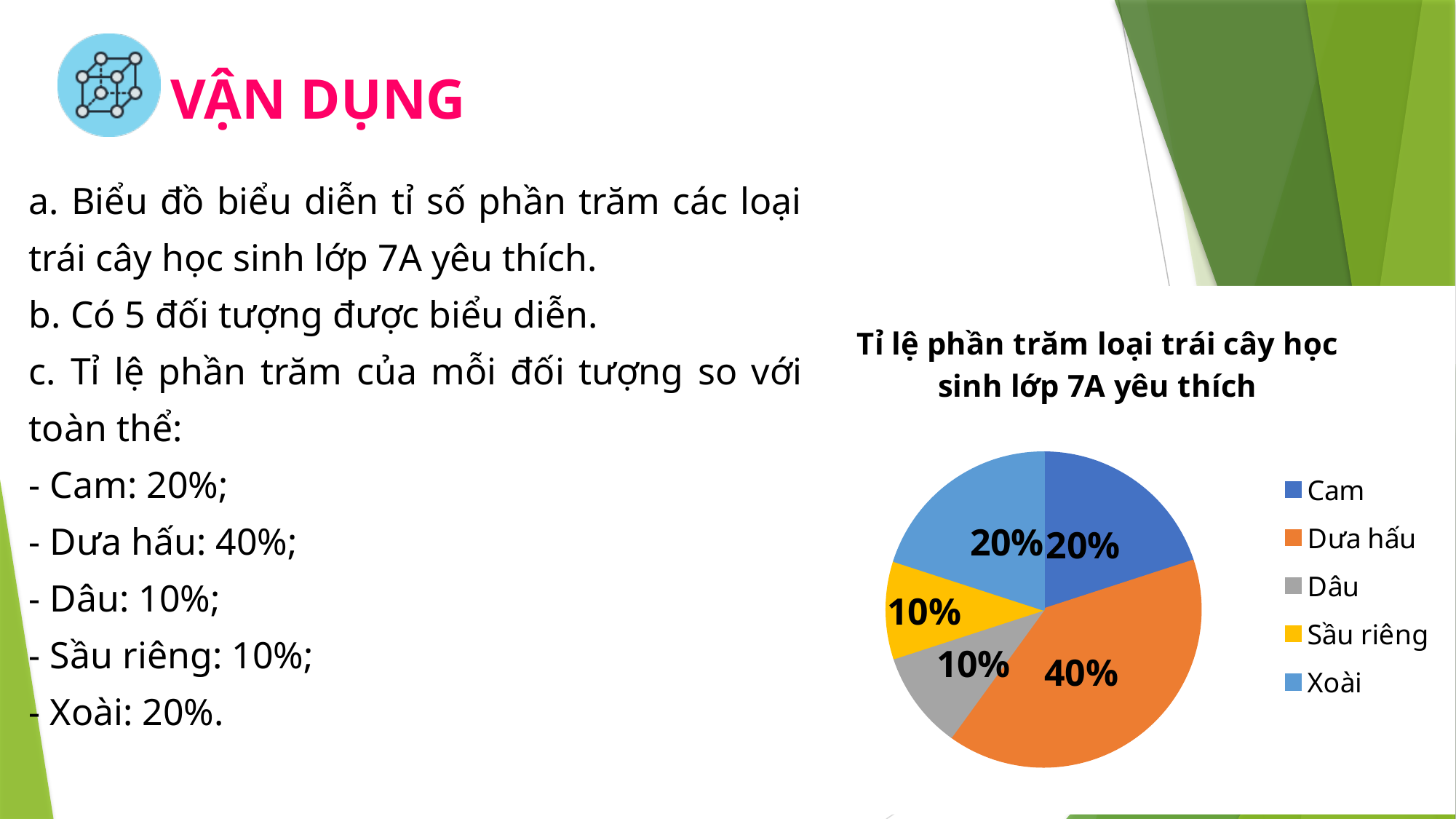
Which fruit has the largest slice in the pie chart? Dưa hấu What percentage of the pie chart is Dưa hấu? 40% What percentage of the pie chart is Dâu? 10% How many categories does the pie chart show? 5 What percentage of the pie chart is Xoài? 20% What kind of chart is shown on the slide? pie chart What percentage of the pie chart is Cam? 20% What is the title of the pie chart? Tỉ lệ phần trăm loại trái cây học sinh lớp 7A yêu thích What percentage of the pie chart is Sầu riêng? 10% Which is larger in the pie chart, Cam or Sầu riêng? Cam What is the difference between the Dưa hấu slice and the Dâu slice? 30% Which colour represents Xoài in the pie chart? light blue